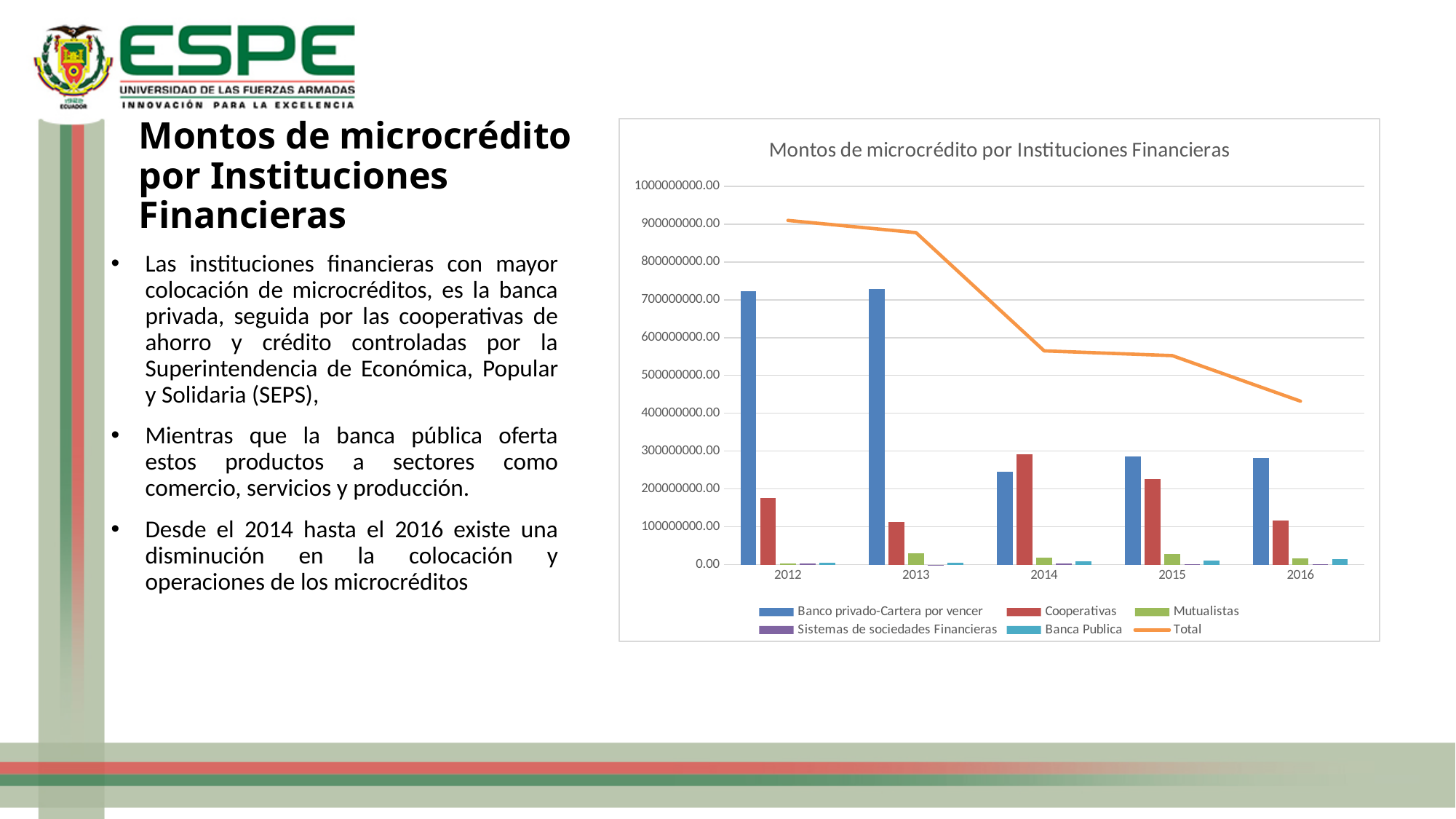
Does the Total line rise or fall from 2012 to 2016? It falls What is the title of the chart? Montos de microcrédito por Instituciones Financieras Is the Total value for 2012 greater or less than 800000000.00? greater How many years are shown on the x axis of the chart? 5 What colour is the Total line in the chart? Orange In which year is the Banco privado-Cartera por vencer bar the lowest? 2014 What kind of chart is shown on the slide? A bar chart combined with a line Is the Banco privado-Cartera por vencer value for 2012 greater or less than 600000000.00? greater In 2014, which is larger: Banco privado-Cartera por vencer or Cooperativas? Cooperativas Is the Total value for 2016 greater or less than 500000000.00? less How many series does the chart legend list? 6 In which year is the Cooperativas bar the highest? 2014